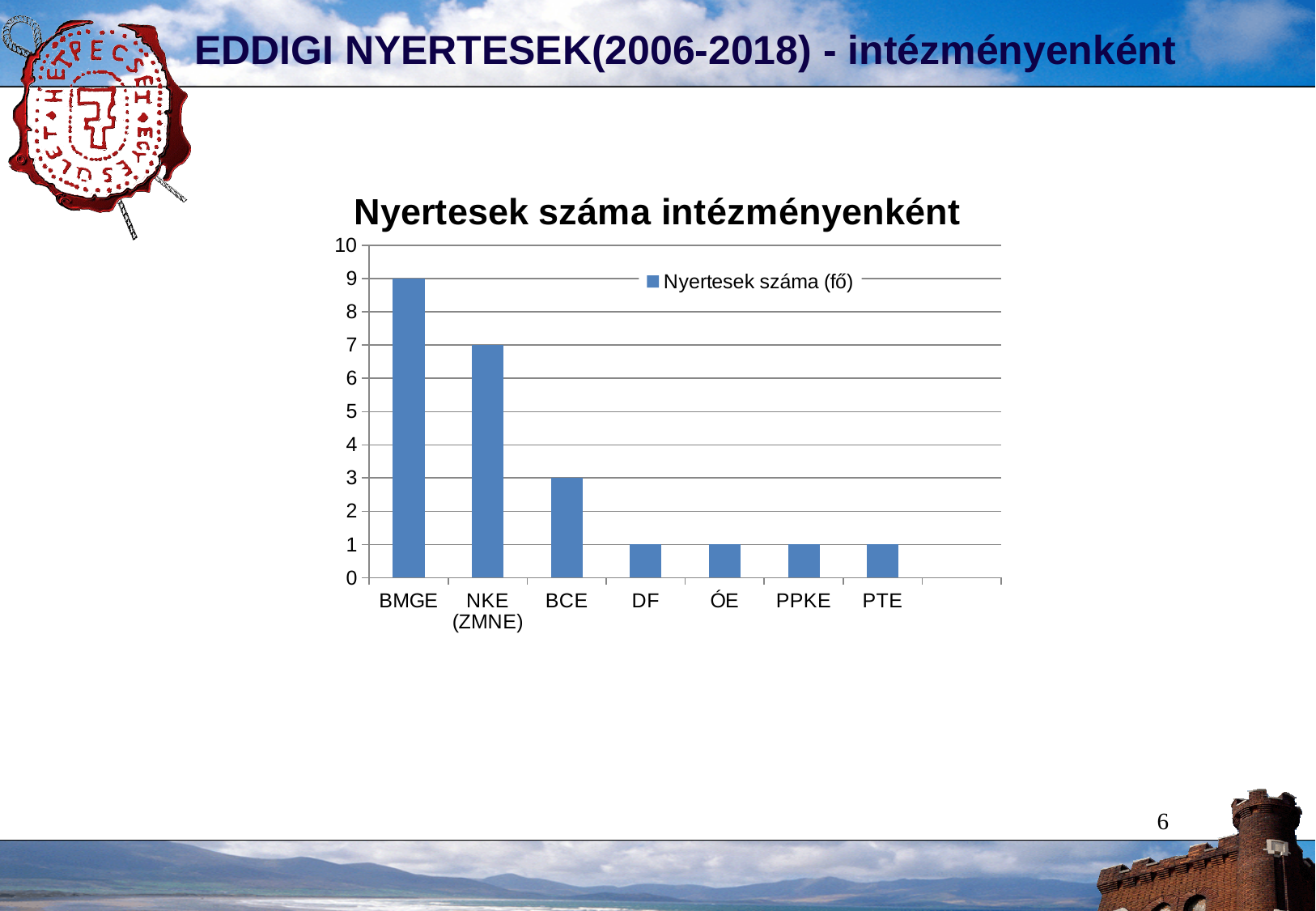
How many series does the legend list? 1 Which institution has the highest number of winners? BMGE Which is larger, the value for BCE or the value for DF? BCE What is the value for PTE? 1 What is the difference between the values for BMGE and NKE (ZMNE)? 2 What is the value for NKE (ZMNE)? 7 Is the value for NKE (ZMNE) greater or less than 5? greater What is the value for BCE? 3 How many institutions (categories) are shown on the x axis? 7 What is the title of the chart? Nyertesek száma intézményenként What is the value for BMGE? 9 What kind of chart is shown on the slide? bar chart